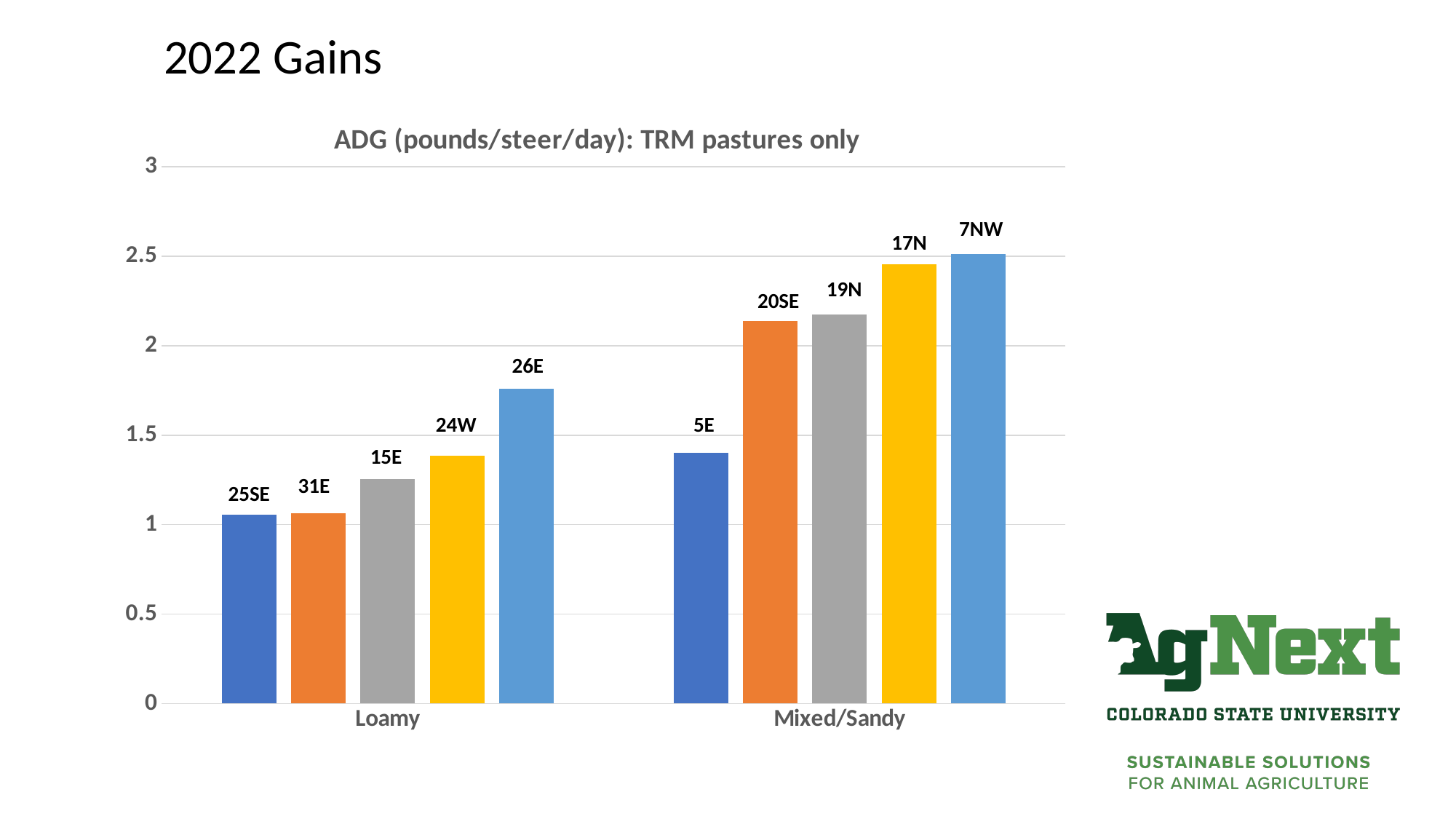
Is the ADG for pasture 26E greater or less than 2? less Which pasture has the lowest ADG within the Mixed/Sandy group? 5E What is the title of the chart? ADG (pounds/steer/day): TRM pastures only Which pasture has the highest ADG in the chart? 7NW How many bars are plotted in the chart in total? 10 How many soil-type categories are shown on the x axis? 2 Within the Mixed/Sandy group, do the bars rise or fall from left to right? rise What kind of chart is shown on the slide? bar chart Is the ADG for pasture 5E greater or less than 1.5? less Which has a higher ADG, pasture 24W or pasture 20SE? 20SE Which pasture has the highest ADG within the Loamy group? 26E